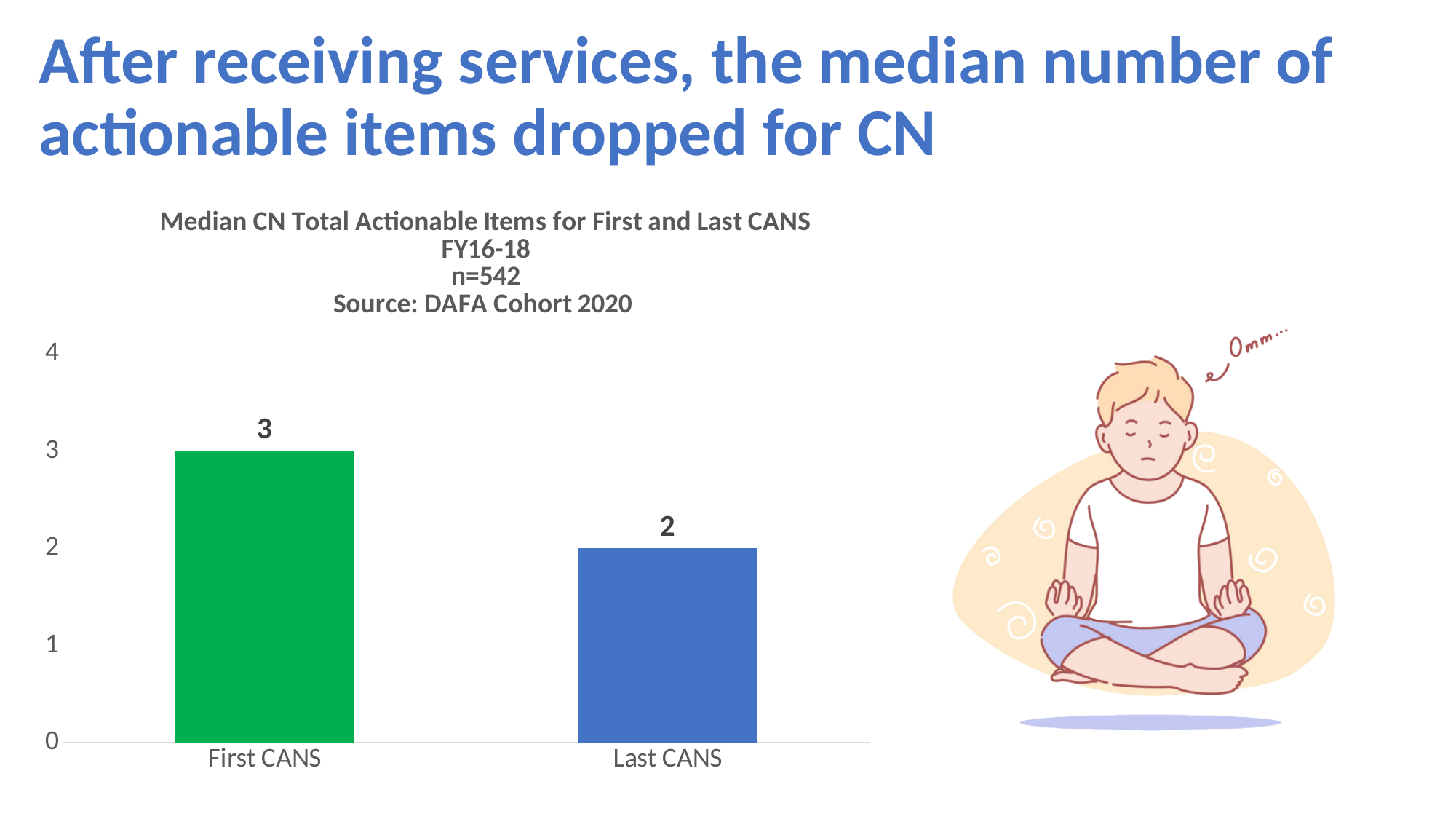
Do the values rise or fall from First CANS to Last CANS? fall What kind of chart is shown on the slide? bar chart What is the difference between the First CANS and Last CANS values? 1 Is the value for Last CANS larger or smaller than the value for First CANS? smaller Which category has the lowest value? Last CANS What is the median CN total actionable items for Last CANS? 2 What is the sample size (n) stated in the chart title? n=542 What is the median CN total actionable items for First CANS? 3 Which category has the higher value, First CANS or Last CANS? First CANS What colour is the First CANS bar? green How many categories are shown on the x axis? 2